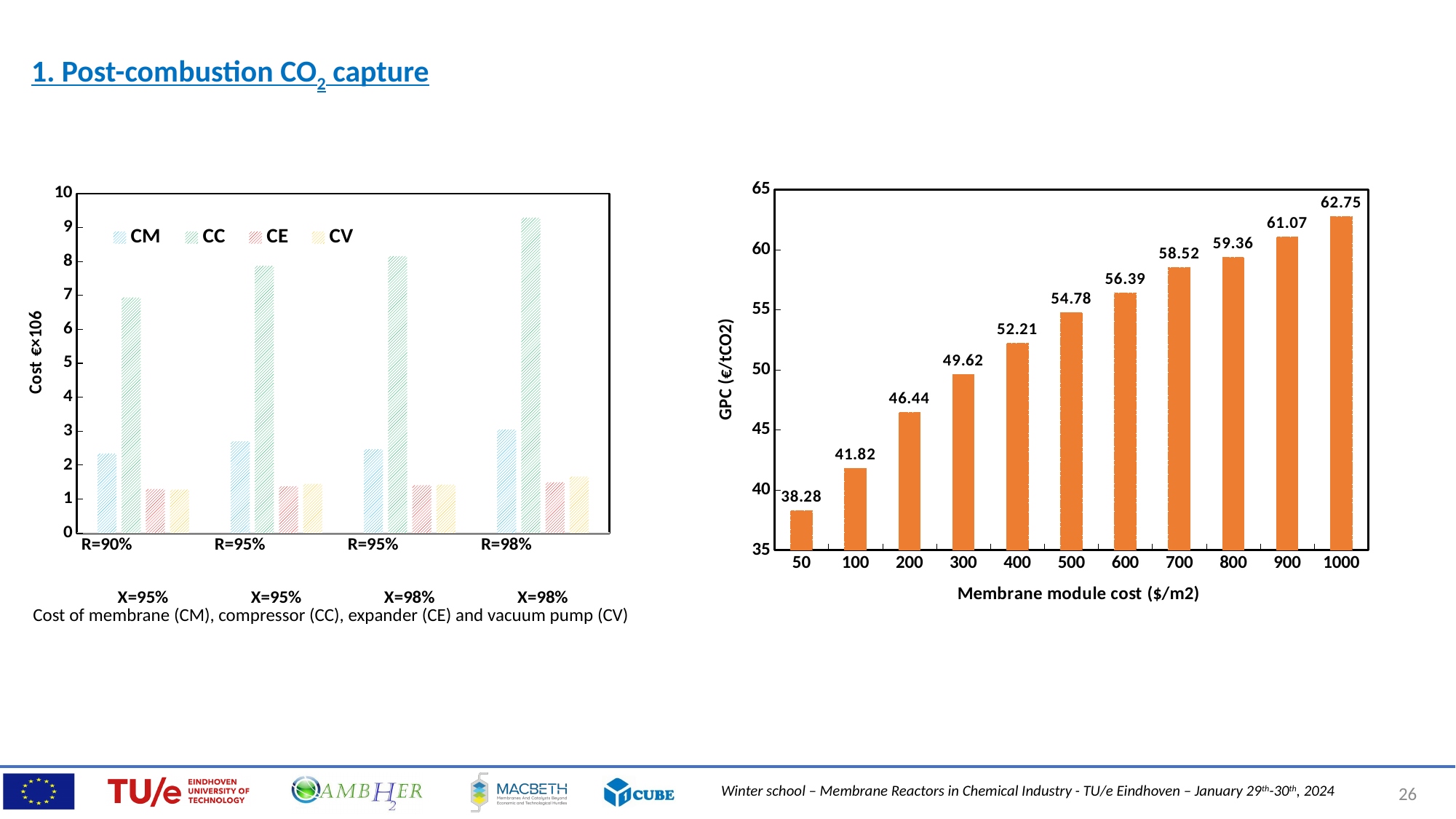
What kind of chart is the left chart (cost of membrane, compressor, expander and vacuum pump)? bar chart In the right chart (GPC vs membrane module cost), which membrane module cost gives the lowest GPC? 50 In the left chart (cost of membrane, compressor, expander and vacuum pump), is the CC value for R=98% / X=98% greater or less than 9? greater In the right chart (GPC vs membrane module cost), which membrane module cost gives the highest GPC? 1000 In the right chart (GPC vs membrane module cost), how many membrane module cost values are plotted? 11 In the right chart (GPC vs membrane module cost), what is the GPC value at a membrane module cost of 50 $/m2? 38.28 In the right chart (GPC vs membrane module cost), does GPC rise or fall as membrane module cost increases? rise In the right chart (GPC vs membrane module cost), what is the GPC value at a membrane module cost of 500 $/m2? 54.78 In the right chart (GPC vs membrane module cost), what is the difference in GPC between a membrane module cost of 1000 and 50 $/m2? 24.47 In the left chart (cost of membrane, compressor, expander and vacuum pump), how many series does the legend list? 4 In the right chart (GPC vs membrane module cost), what is the label on the x axis? Membrane module cost ($/m2) In the left chart (cost of membrane, compressor, expander and vacuum pump), which series has the highest cost in every category? CC